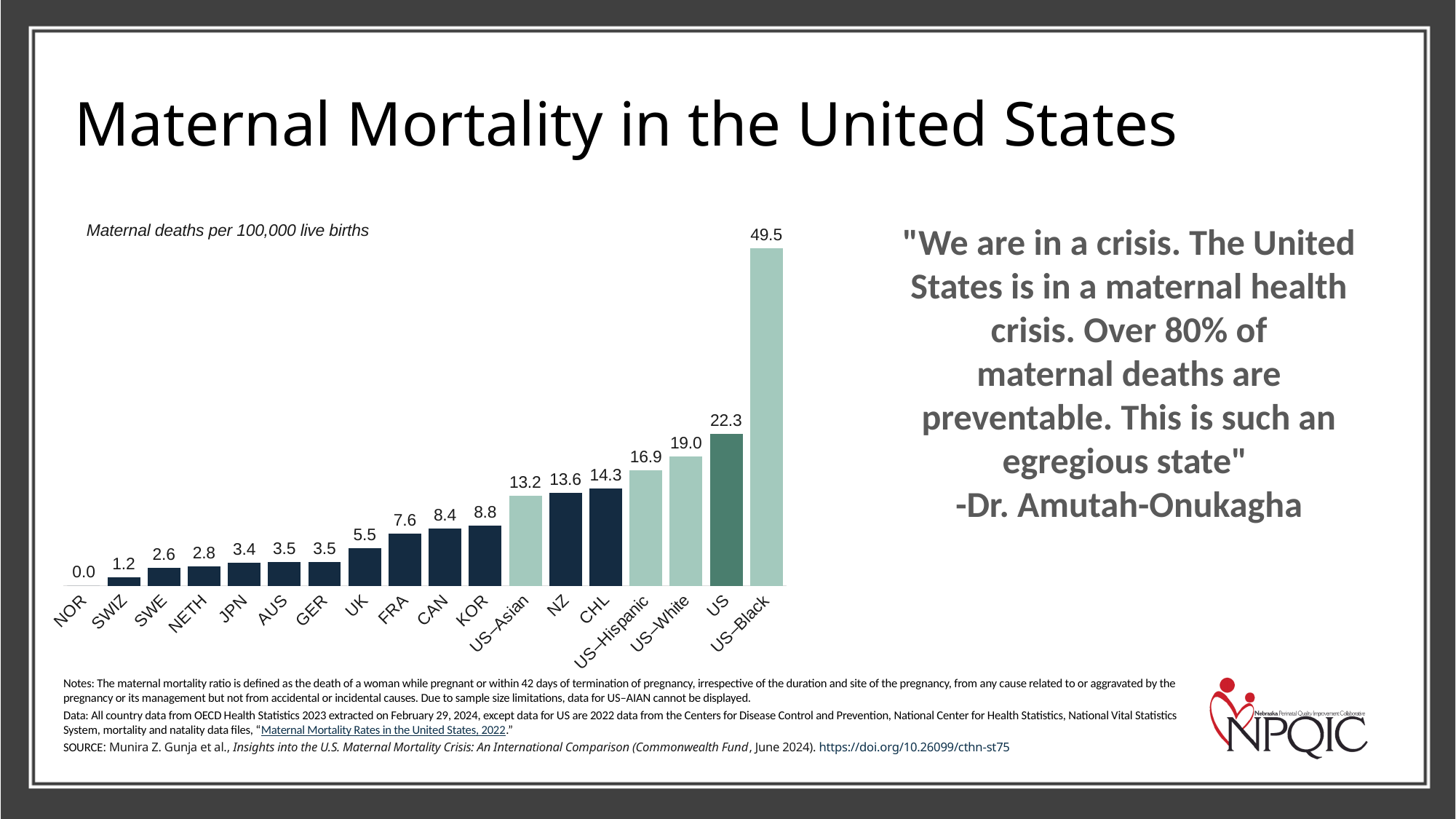
What is the value for US–Hispanic? 16.9 Which category has the lowest value? NOR What is the difference between the US–Black value and the US–White value? 30.5 How many bars are shown in the chart? 18 Which category has the highest value? US–Black What is the value for CAN? 8.4 What kind of chart is shown on the slide? Bar chart What unit does the chart's subtitle say the values are measured in? Maternal deaths per 100,000 live births What is the difference between the US value and the UK value? 16.8 Which is larger, the value for NZ or the value for US–Asian? NZ What is the value for the US bar? 22.3 What is the value for US–Black? 49.5